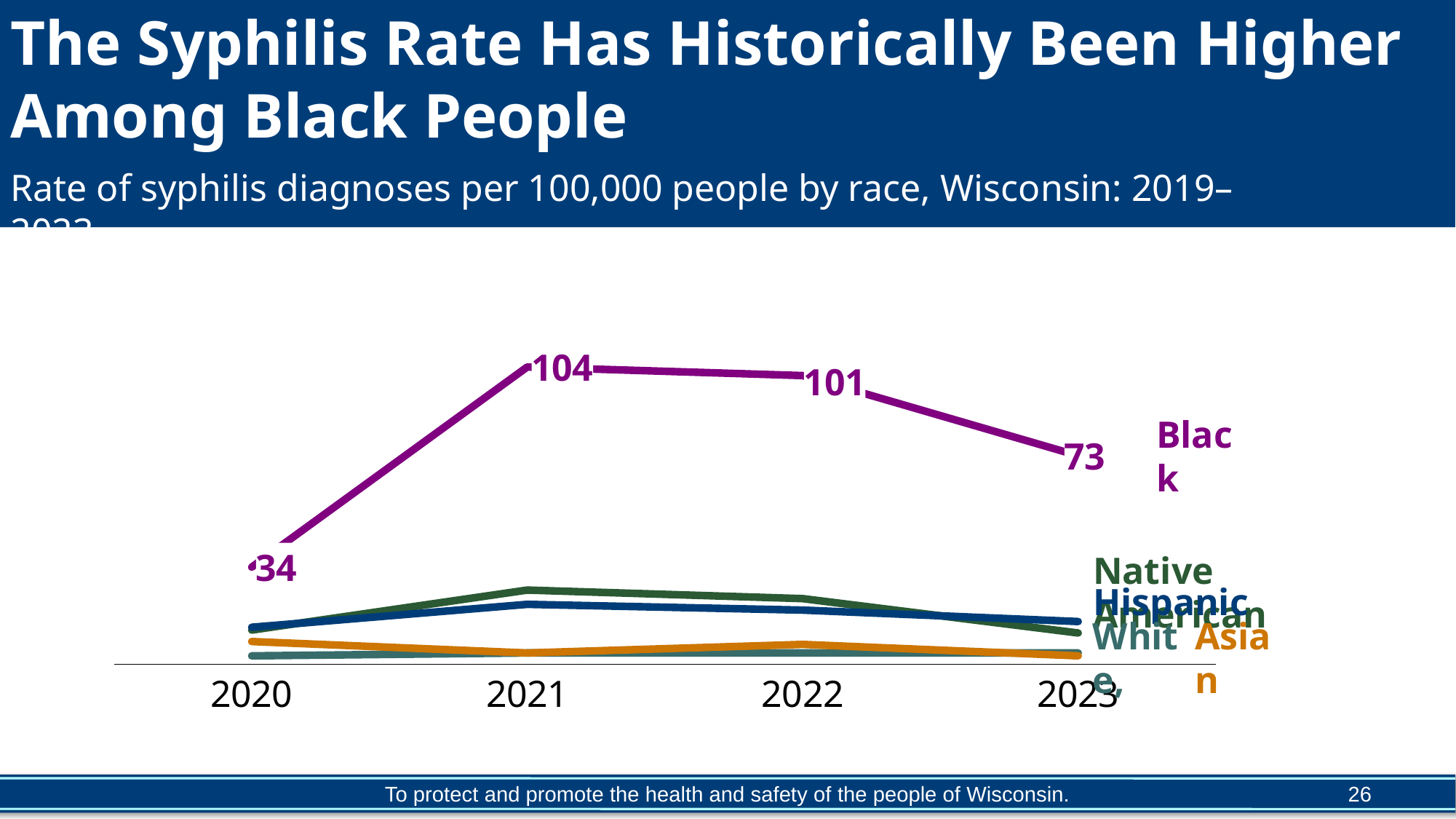
Does the syphilis rate for Black people rise or fall from 2021 to 2023? Fall What is the syphilis rate for Black people in 2021? 104 What is the syphilis rate for Black people in 2020? 34 What is the syphilis rate for Black people in 2023? 73 By how much did the syphilis rate for Black people decrease from 2022 to 2023? 28 How many years are shown on the x axis of the chart? 4 By how much did the syphilis rate for Black people increase from 2020 to 2021? 70 Was the syphilis rate for Black people higher in 2021 or in 2022? 2021 In which year was the syphilis rate for Black people highest? 2021 In which year was the syphilis rate for Black people lowest? 2020 What is the syphilis rate for Black people in 2022? 101 What kind of chart is shown on the slide? Line chart